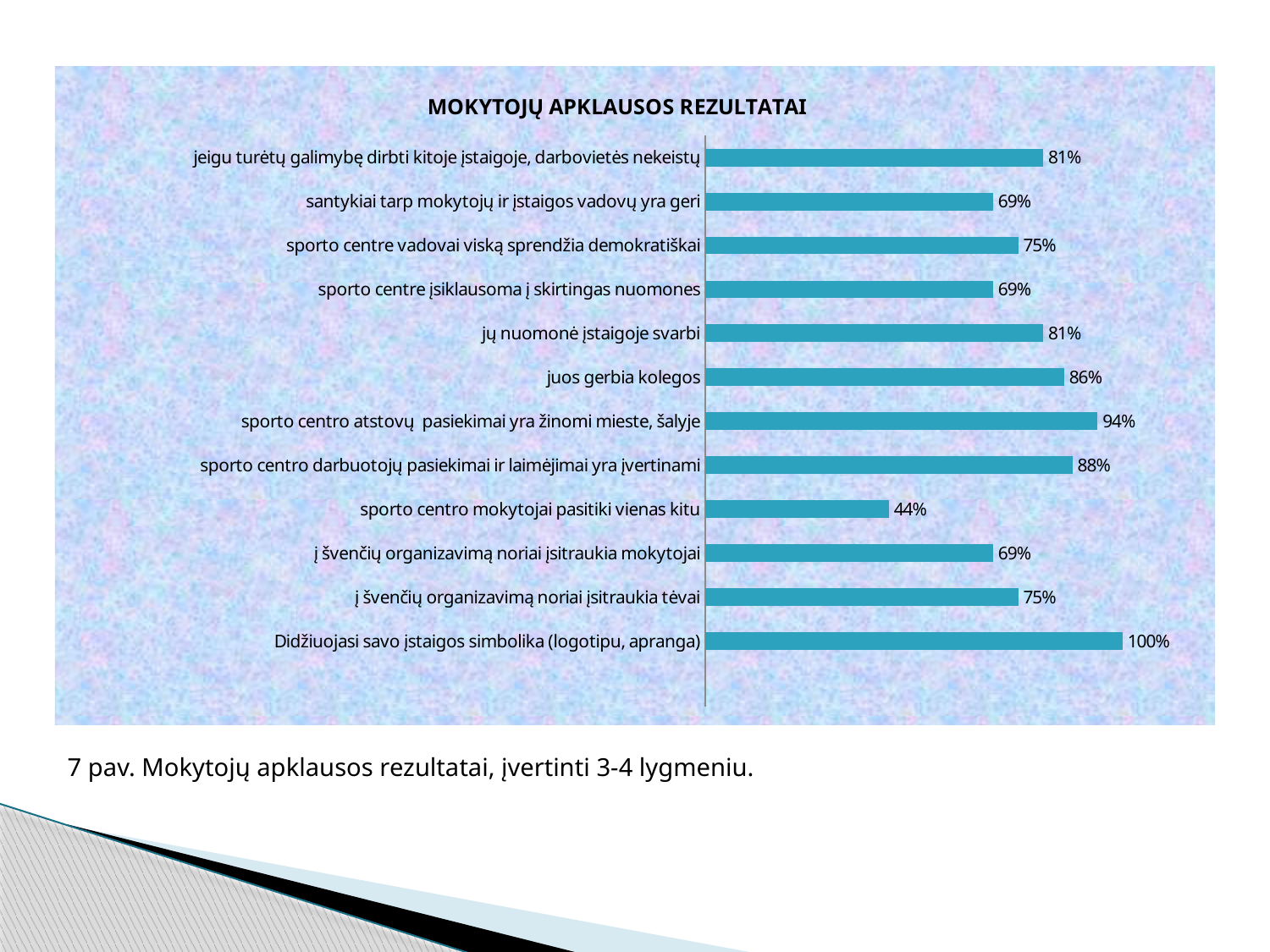
Which is larger: the value for "sporto centro darbuotojų pasiekimai ir laimėjimai yra įvertinami" or the value for "jų nuomonė įstaigoje svarbi"? sporto centro darbuotojų pasiekimai ir laimėjimai yra įvertinami What is the value for "juos gerbia kolegos"? 86% What is the value for "į švenčių organizavimą noriai įsitraukia tėvai"? 75% What is the value for "sporto centro atstovų pasiekimai yra žinomi mieste, šalyje"? 94% What is the difference between the values for "Didžiuojasi savo įstaigos simbolika (logotipu, apranga)" and "sporto centro mokytojai pasitiki vienas kitu"? 56% What kind of chart is shown on the slide? bar chart What is the value for "sporto centro mokytojai pasitiki vienas kitu"? 44% What is the title of the chart? MOKYTOJŲ APKLAUSOS REZULTATAI Which category has the lowest value? sporto centro mokytojai pasitiki vienas kitu What is the difference between the values for "juos gerbia kolegos" and "santykiai tarp mokytojų ir įstaigos vadovų yra geri"? 17% Which category has the highest value? Didžiuojasi savo įstaigos simbolika (logotipu, apranga) How many categories are shown in the chart? 12